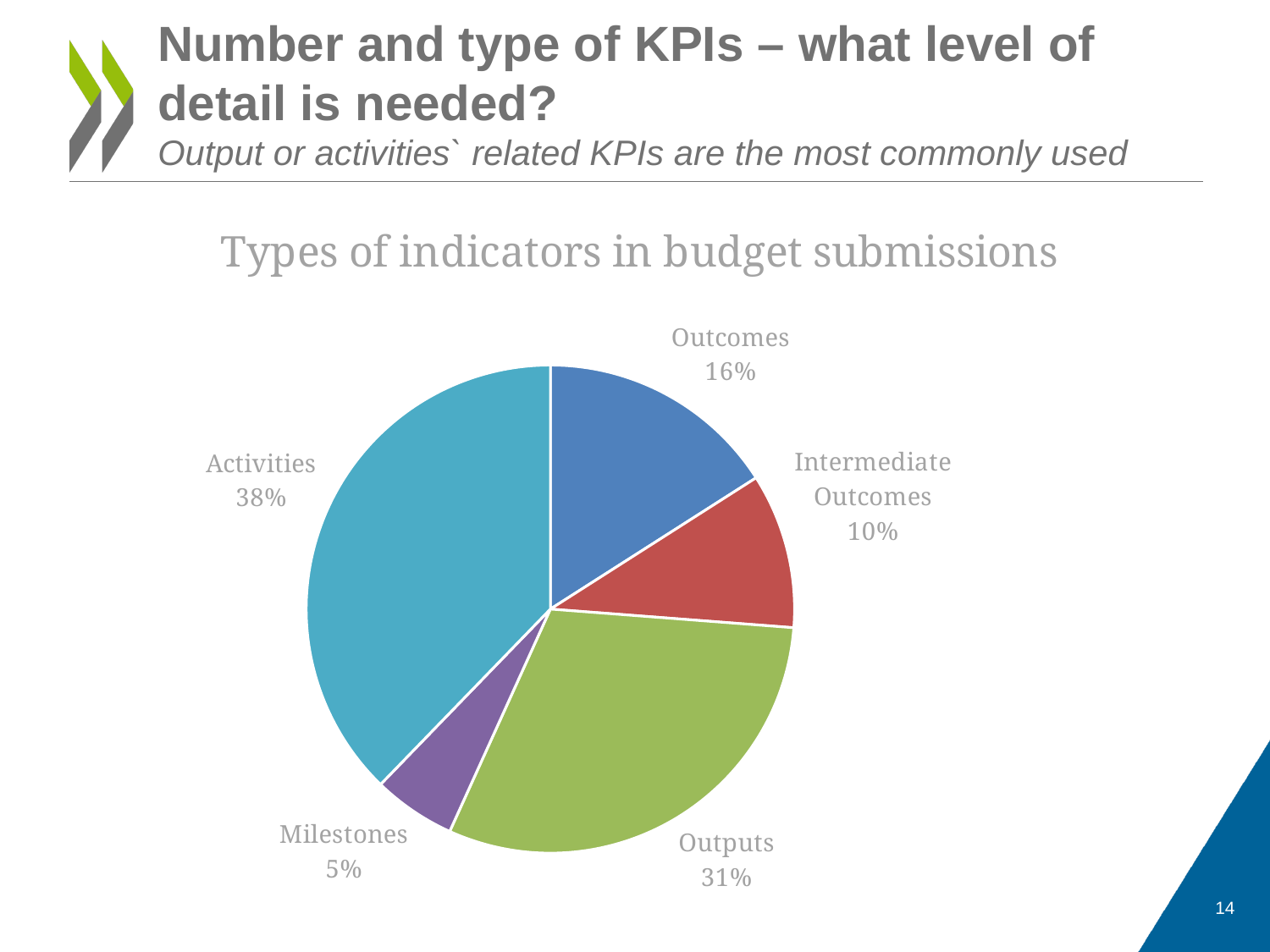
Which type of indicator has the largest share? Activities What share of indicators are Activities? 38% What share of indicators are Milestones? 5% How many slices does the pie chart have? 5 What is the title of the chart? Types of indicators in budget submissions What share of indicators are Outputs? 31% What share of indicators are Intermediate Outcomes? 10% Which is larger, the share for Outcomes or the share for Intermediate Outcomes? Outcomes Which type of indicator has the smallest share? Milestones What colour is the Outputs slice? green What type of chart is shown on the slide? pie chart What is the difference in percentage points between Activities and Outputs? 7